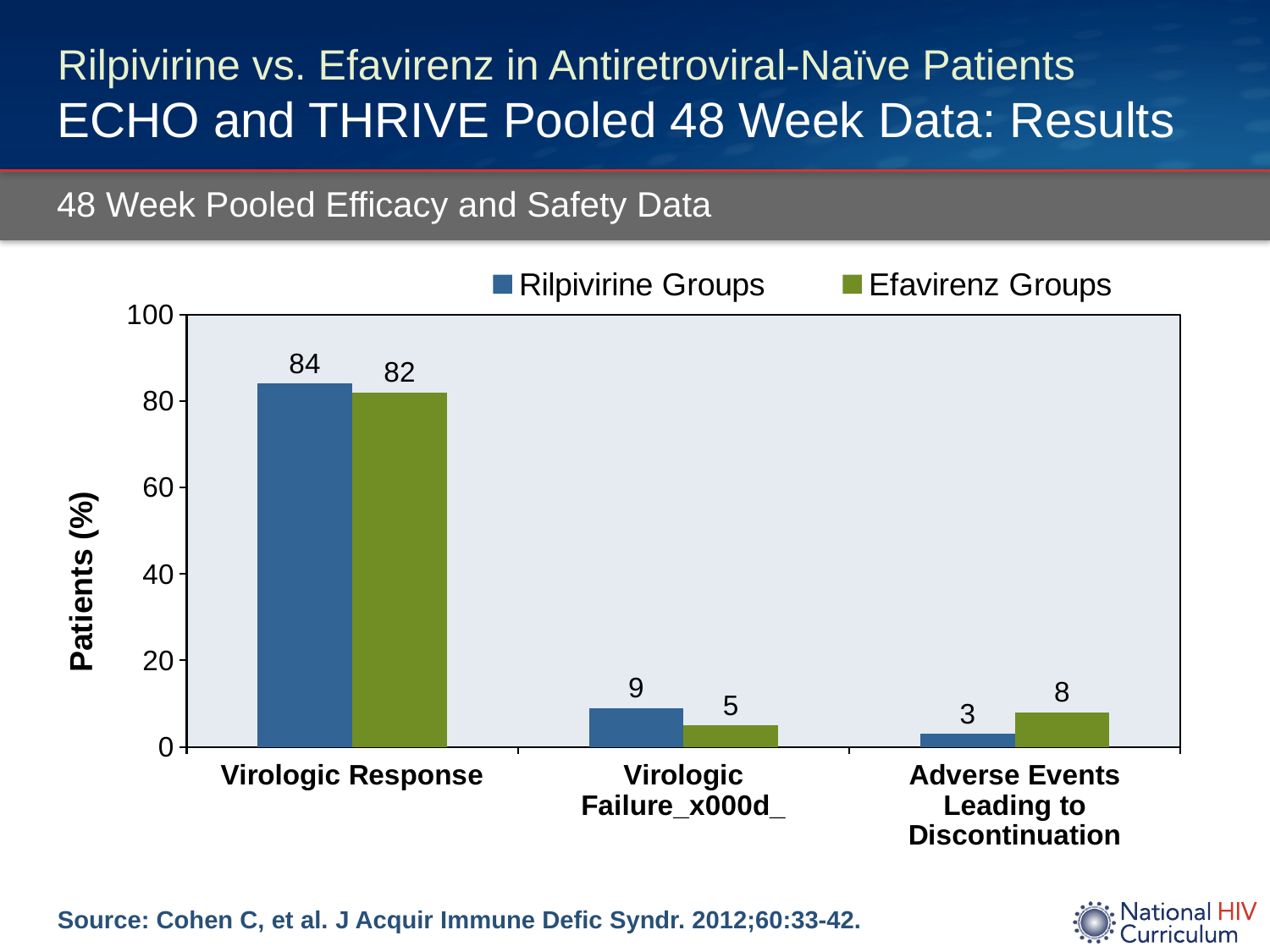
Is the value for Rilpivirine Groups for Virologic Response greater or less than 80? greater What is the difference between the Rilpivirine Groups and Efavirenz Groups values for Virologic Failure? 4 How many series does the legend list? 2 What is the value for Rilpivirine Groups for Virologic Response? 84 How many categories are shown on the x axis? 3 What is the value for Efavirenz Groups for Virologic Response? 82 Which category has the lowest value for Rilpivirine Groups? Adverse Events Leading to Discontinuation What is the value for Rilpivirine Groups for Virologic Failure? 9 For Adverse Events Leading to Discontinuation, which group has the larger value, Rilpivirine Groups or Efavirenz Groups? Efavirenz Groups What is the value for Efavirenz Groups for Adverse Events Leading to Discontinuation? 8 What kind of chart is shown on the slide? bar chart Which category has the highest value for Efavirenz Groups? Virologic Response